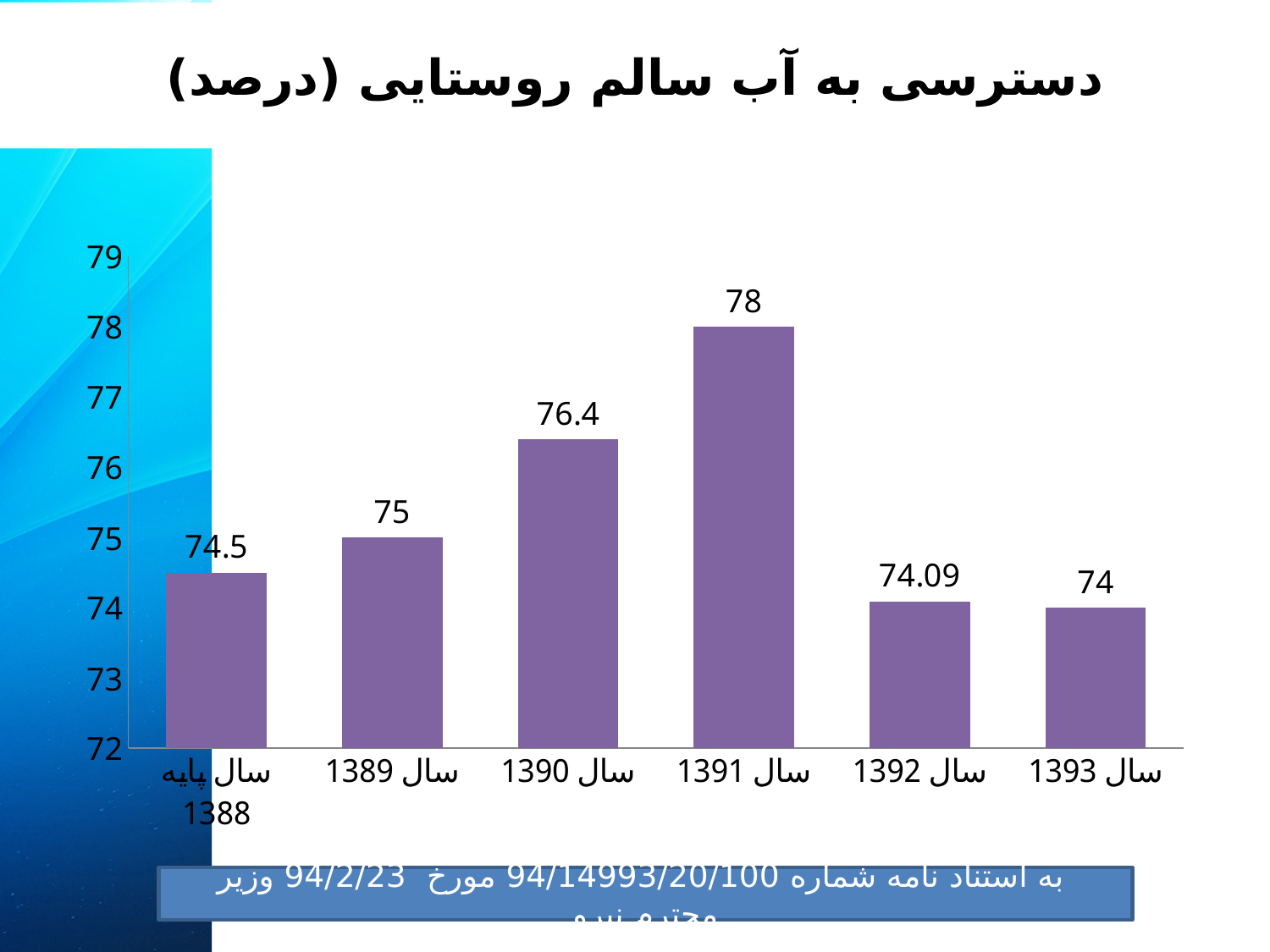
What is the difference between the values for سال 1391 and سال 1393? 4 Which is larger, the value for سال 1389 or the value for سال 1392? سال 1389 What is the value for سال 1392? 74.09 What is the difference between the values for سال 1390 and سال 1389? 1.4 How many bars are shown in the chart? 6 Which year has the highest value? سال 1391 What is the value for سال پایه 1388? 74.5 What is the value for سال 1390? 76.4 What is the title of the chart? دسترسی به آب سالم روستایی (درصد) What kind of chart is shown on the slide? bar chart What is the value for سال 1391? 78 Which year has the lowest value? سال 1393